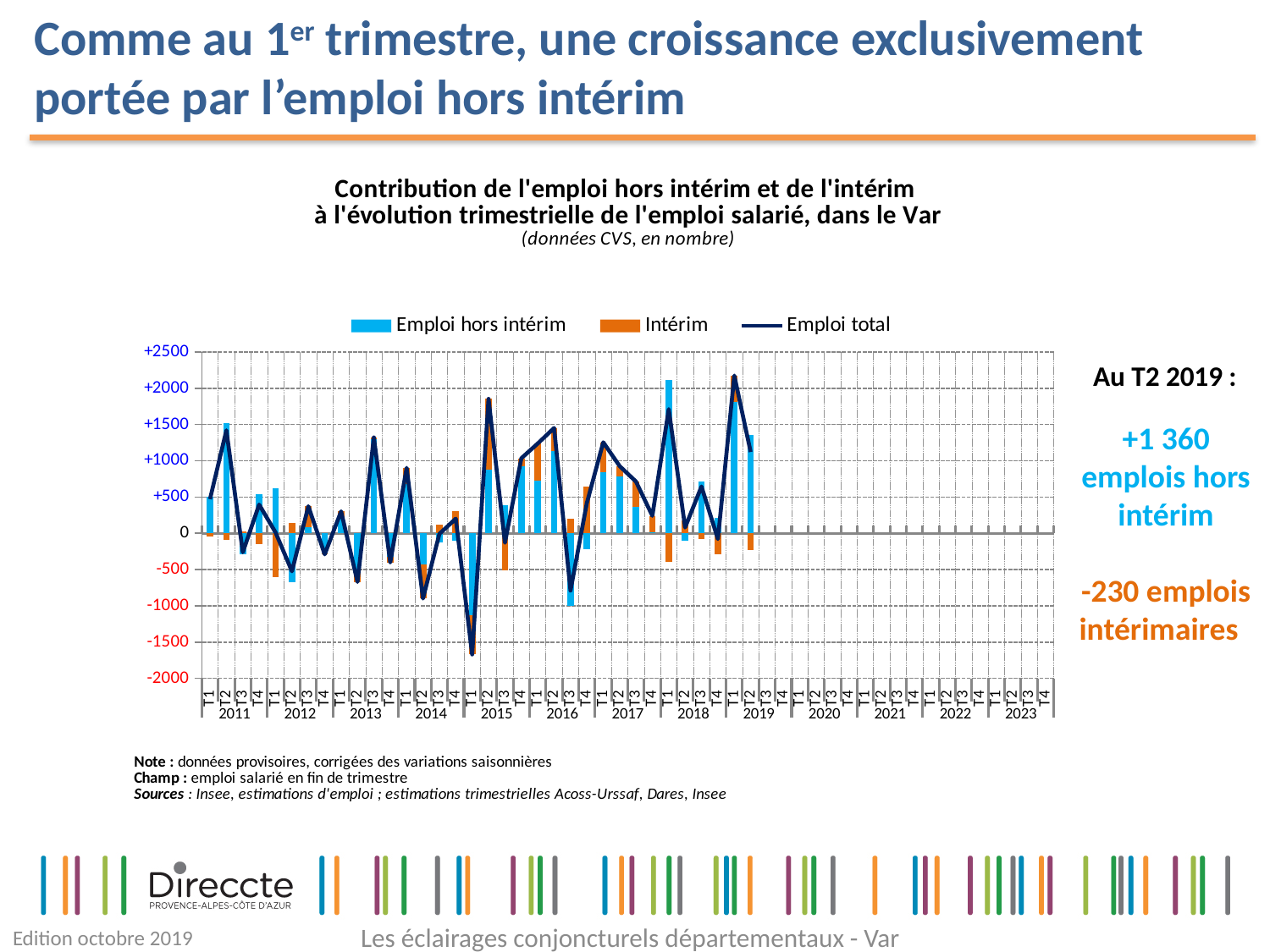
What kind of chart is shown on the slide? A combined bar and line chart According to the slide, what is the contribution of 'emploi hors intérim' at T2 2019? +1 360 Is the value of Emploi hors intérim at T1 2018 greater or less than +1500? greater In which quarter does the Emploi total line reach its lowest point? T1 2015 Which is larger, the Emploi hors intérim value at T1 2018 or at T2 2019? T1 2018 How many years are labelled along the x axis of the chart? 13 Which series is drawn as a line rather than bars? Emploi total Is the value of Emploi total at T1 2015 greater or less than -1000? less In which quarter does the Emploi total line reach its highest point? T1 2019 How many series does the chart legend list? 3 According to the slide, what is the contribution of 'emplois intérimaires' at T2 2019? -230 Which is larger, the Emploi hors intérim value at T2 2011 or at T2 2012? T2 2011